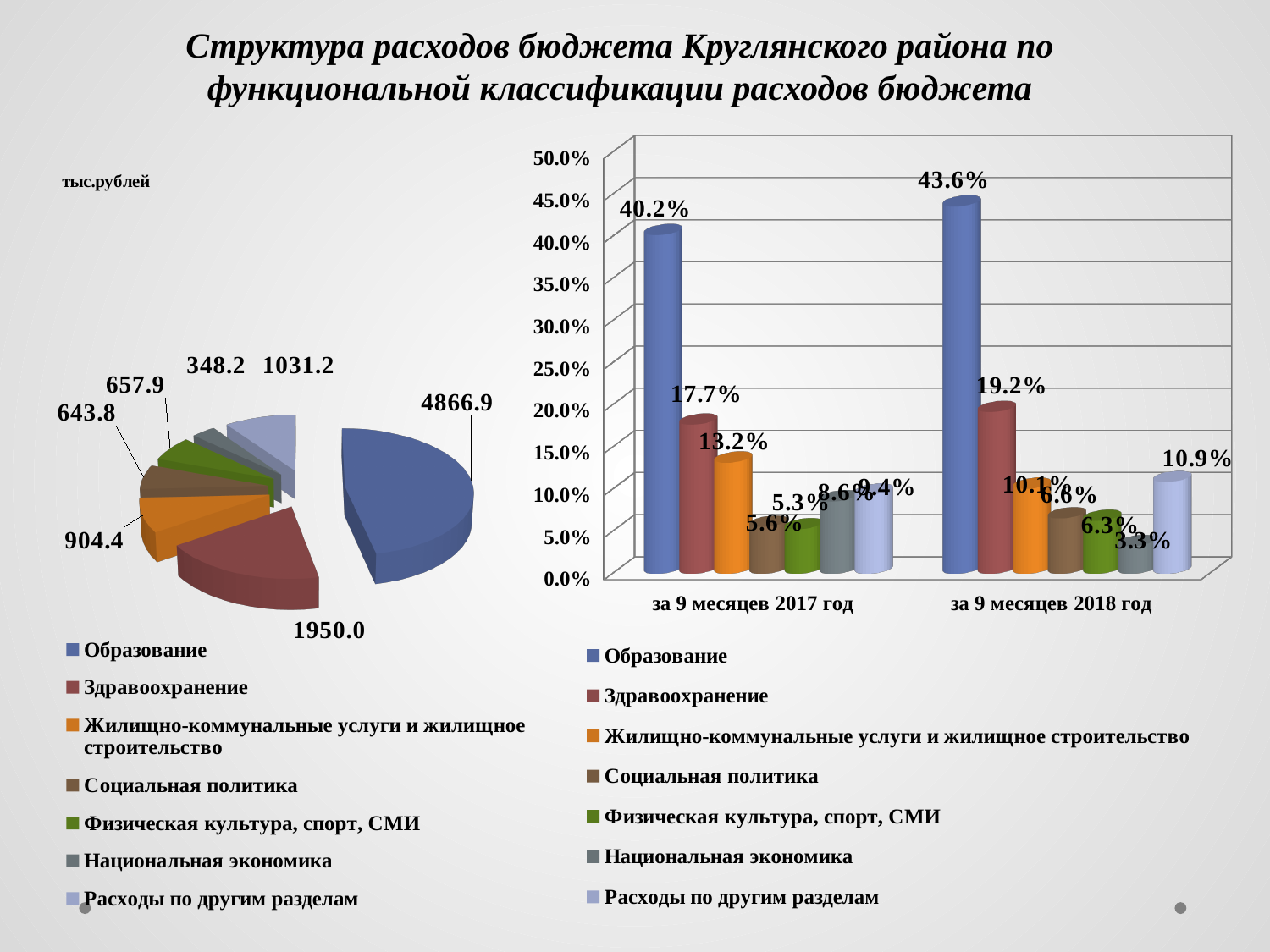
In the bar chart on the right, what is the value for Расходы по другим разделам за 9 месяцев 2018 год? 10.9% In the bar chart on the right, by how many percentage points did the value for Образование change from 2017 to 2018? 3.4 In the pie chart on the left, which category has the smallest value? Национальная экономика In the bar chart on the right, is the value for Жилищно-коммунальные услуги и жилищное строительство larger за 9 месяцев 2017 год or за 9 месяцев 2018 год? за 9 месяцев 2017 год In the pie chart on the left, what is the value for Здравоохранение? 1950.0 In the bar chart on the right, which category has the highest value за 9 месяцев 2017 год? Образование In the bar chart on the right, what is the value for Здравоохранение за 9 месяцев 2017 год? 17.7% In the bar chart on the right, what is the value for Образование за 9 месяцев 2018 год? 43.6% In the bar chart on the right, which category has the lowest value за 9 месяцев 2018 год? Национальная экономика How many series does the legend of the bar chart on the right list? 7 In the pie chart on the left, what is the value for Образование? 4866.9 What type of chart is shown on the left side of the slide? Pie chart